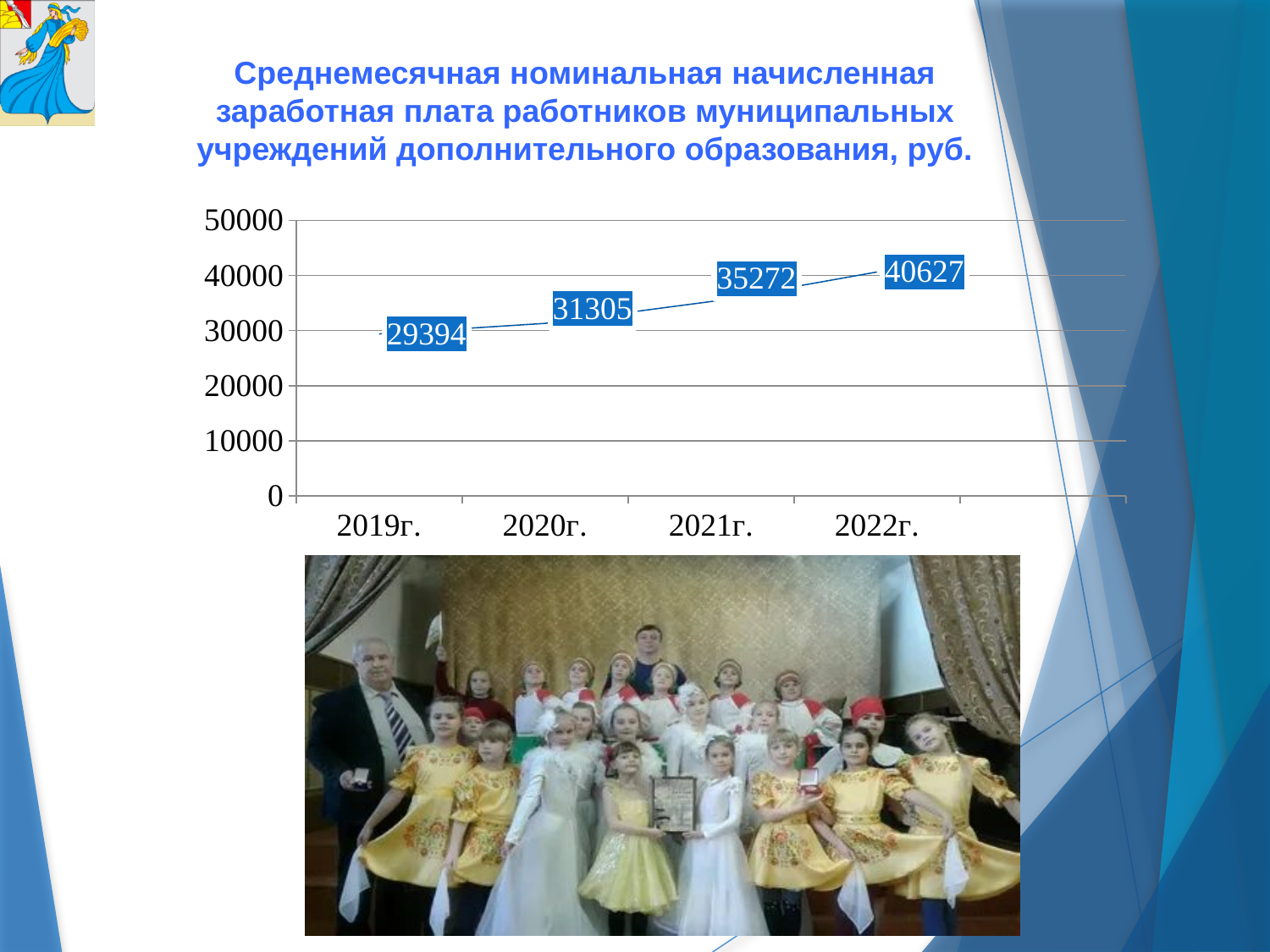
Is the value for 2022г. greater or less than 40000? greater What is the value for 2019г.? 29394 Which year has the lowest value? 2019г. Which is larger, the value for 2021г. or the value for 2020г.? 2021г. Which year has the highest value? 2022г. What is the value for 2022г.? 40627 How many years are plotted on the chart? 4 Do the values rise or fall from 2019г. to 2022г.? rise What is the value for 2021г.? 35272 What is the value for 2020г.? 31305 What is the difference between the values for 2022г. and 2021г.? 5355 What is the difference between the values for 2020г. and 2019г.? 1911